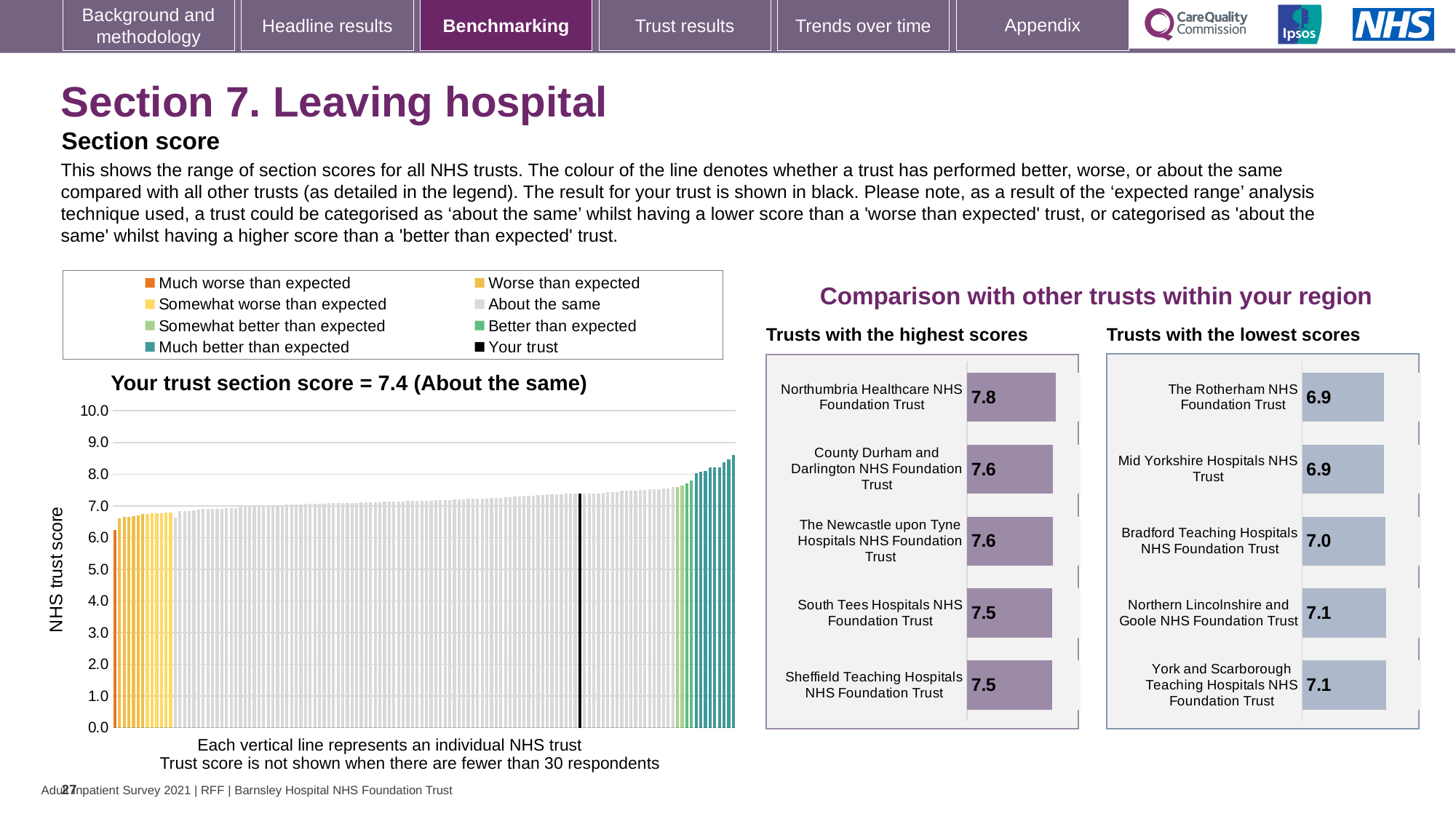
How many trusts are shown in the 'Trusts with the highest scores' chart? 5 In the 'Trusts with the lowest scores' chart, what is the score for Bradford Teaching Hospitals NHS Foundation Trust? 7.0 In the 'Your trust section score' chart, do the bar values rise or fall from left to right? Rise In the 'Trusts with the lowest scores' chart, what is the difference between the scores of York and Scarborough Teaching Hospitals NHS Foundation Trust and The Rotherham NHS Foundation Trust? 0.2 How many entries does the legend above the 'Your trust section score' chart list? 8 In the 'Trusts with the highest scores' chart, what is the score for Northumbria Healthcare NHS Foundation Trust? 7.8 In the 'Trusts with the highest scores' chart, what is the difference between the scores of Northumbria Healthcare NHS Foundation Trust and Sheffield Teaching Hospitals NHS Foundation Trust? 0.3 What kind of chart is the 'Your trust section score' chart on the left of the slide? Bar chart In the 'Your trust section score' chart, what is the section score for your trust? 7.4 In the 'Your trust section score' chart, what is the highest value shown on the y axis? 10.0 In the 'Trusts with the highest scores' chart, which trust has the highest score? Northumbria Healthcare NHS Foundation Trust Which is larger: the score for Mid Yorkshire Hospitals NHS Trust in the 'Trusts with the lowest scores' chart or the score for South Tees Hospitals NHS Foundation Trust in the 'Trusts with the highest scores' chart? South Tees Hospitals NHS Foundation Trust